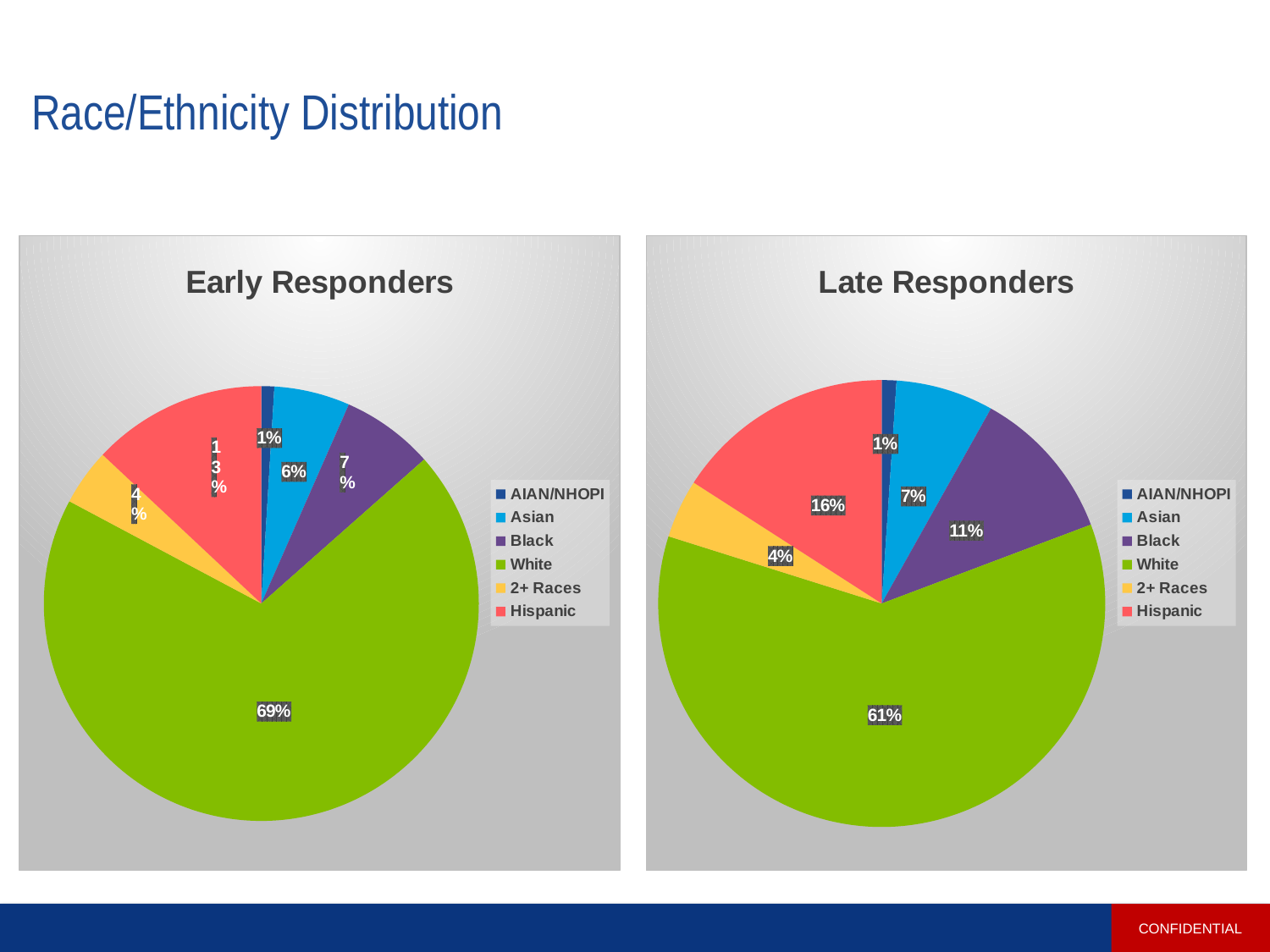
In the Early Responders chart, what share of the pie is White? 69% In the Late Responders chart, what share of the pie is Hispanic? 16% In the Late Responders chart, which category has the smallest slice? AIAN/NHOPI Which is larger: the Black share in the Early Responders chart or the Black share in the Late Responders chart? Late Responders What colour represents Hispanic in the legend of the Early Responders chart? Red What type of chart is the Late Responders chart? Pie chart How many categories does the Early Responders pie chart show? 6 In the Late Responders chart, what is the value for Black? 11% In the Late Responders chart, what is the combined share of Asian and Black? 18% What is the difference between the White share in the Early Responders chart and the White share in the Late Responders chart? 8% In the Early Responders chart, what is the value for Asian? 6% In the Early Responders chart, which category has the largest slice? White